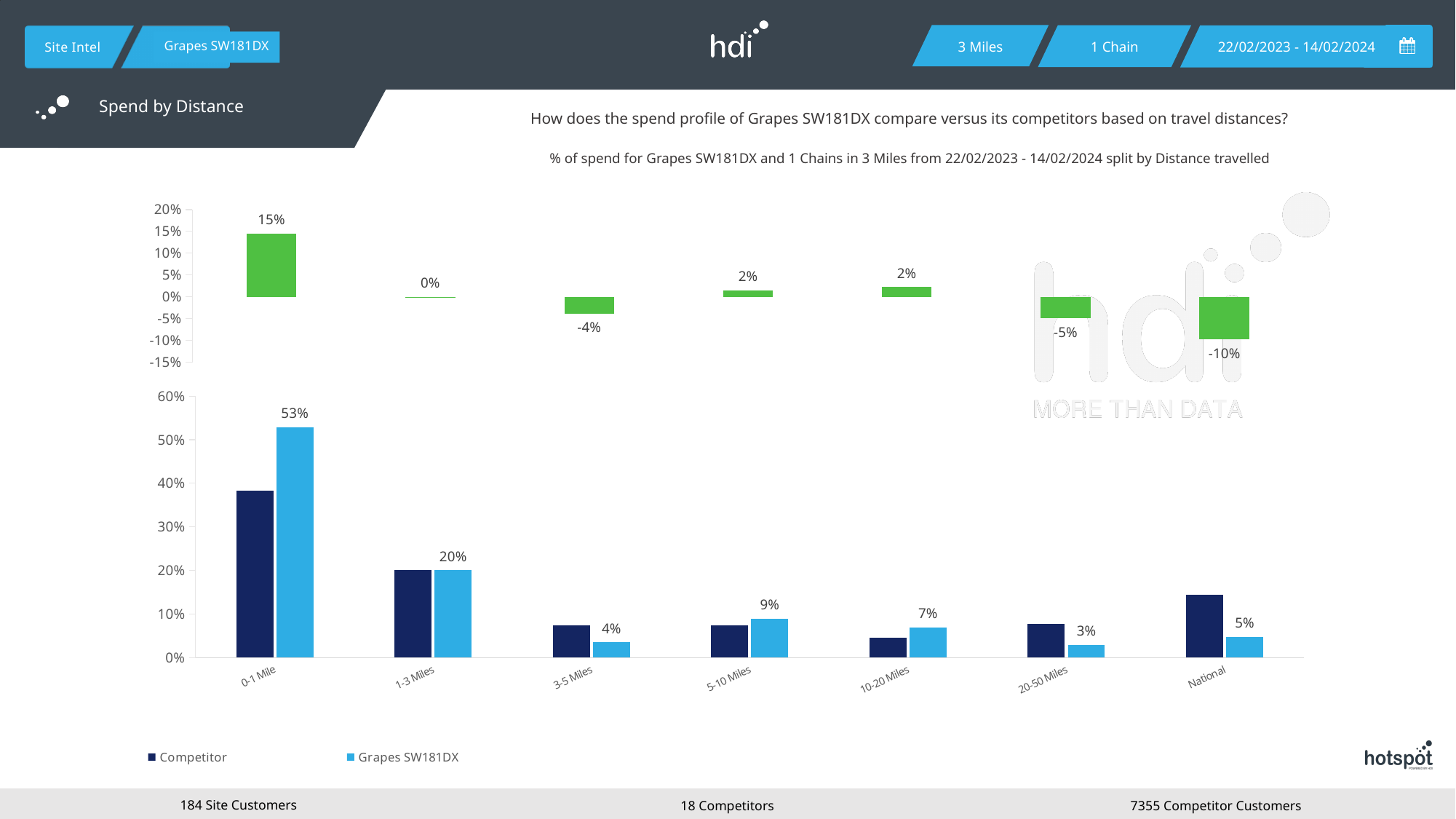
How many series does the legend of the bottom chart list? 2 In the bottom chart, is the Competitor value for National greater or less than 10%? greater In the bottom chart, what is the difference between the Grapes SW181DX values for 0-1 Mile and 1-3 Miles? 33 percentage points What type of chart is the bottom chart? Bar chart In the top chart, which category has the lowest value? National How many distance categories are shown on the x axis of the bottom chart? 7 In the top chart, what is the value shown for the National category? -10% In the bottom chart, is the Competitor value for 0-1 Mile greater or less than 30%? greater In the bottom chart, what is the value for Grapes SW181DX in the 0-1 Mile category? 53% In the top chart, what is the value shown for the 0-1 Mile category? 15% In the bottom chart, for the 5-10 Miles category, which series has the larger value, Competitor or Grapes SW181DX? Grapes SW181DX In the top chart, which category has the highest value? 0-1 Mile